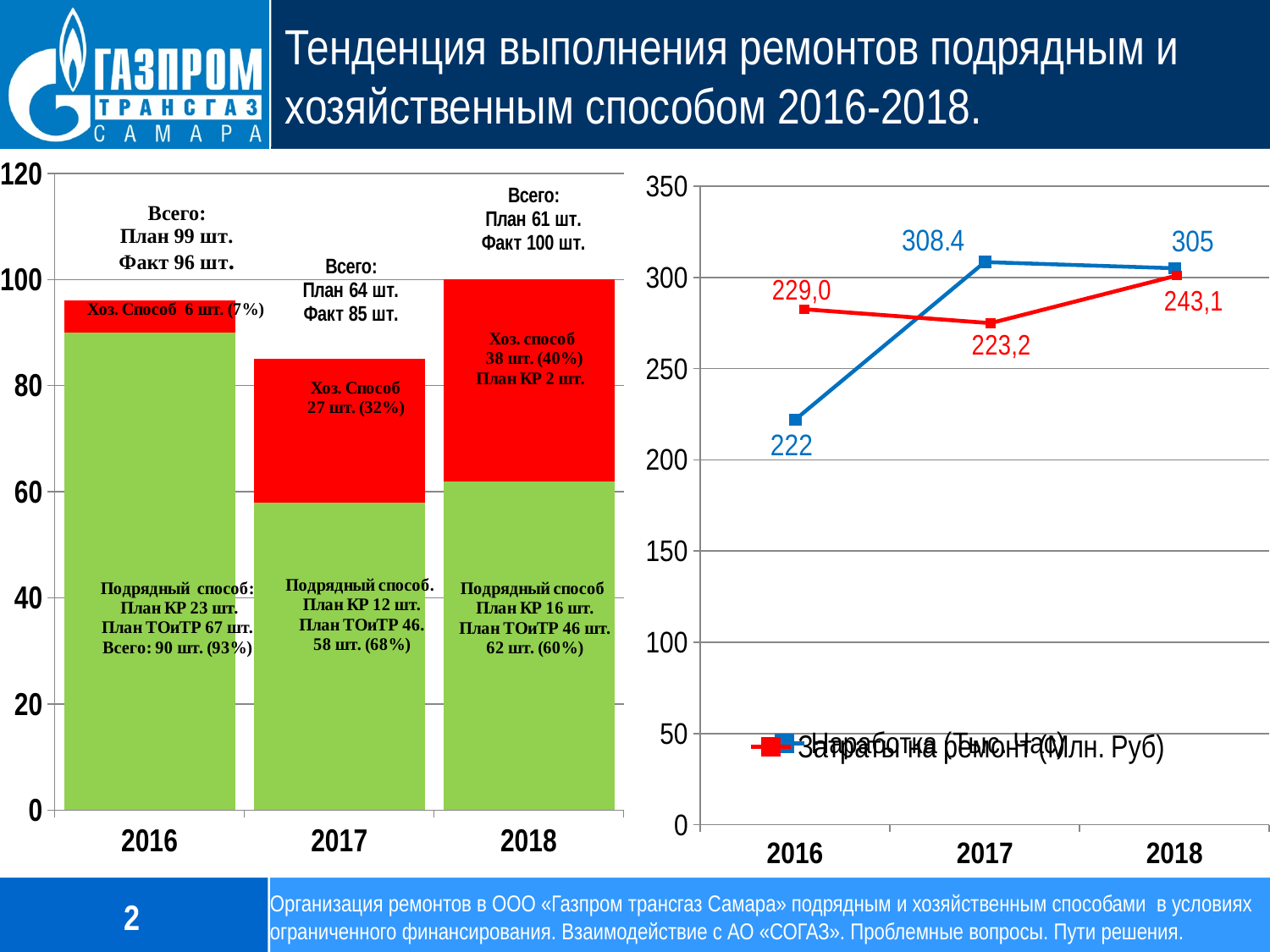
How many years are shown on the x axis of the left bar chart? 3 On the left bar chart, how many repairs were done by Хоз. способ in 2017? 27 шт. On the left bar chart, is the total bar height for 2017 greater or less than 80? greater On the right line chart, what is the value of the blue series (Наработка) in 2017? 308.4 On the right line chart, in 2016, which is larger: the blue series (Наработка) or the red series (Затраты на ремонт)? Затраты на ремонт How many series does the legend of the right chart list? 2 On the right line chart, in which year is the red series (Затраты на ремонт) lowest? 2017 On the right line chart, does the blue series (Наработка) rise or fall from 2016 to 2017? rise On the right line chart, in which year is the blue series (Наработка) highest? 2017 What kind of chart is the left chart? bar chart On the right line chart, by how much did the blue series (Наработка) increase from 2016 to 2017? 86.4 On the right line chart, what is the value of the red series (Затраты на ремонт) in 2018? 243,1